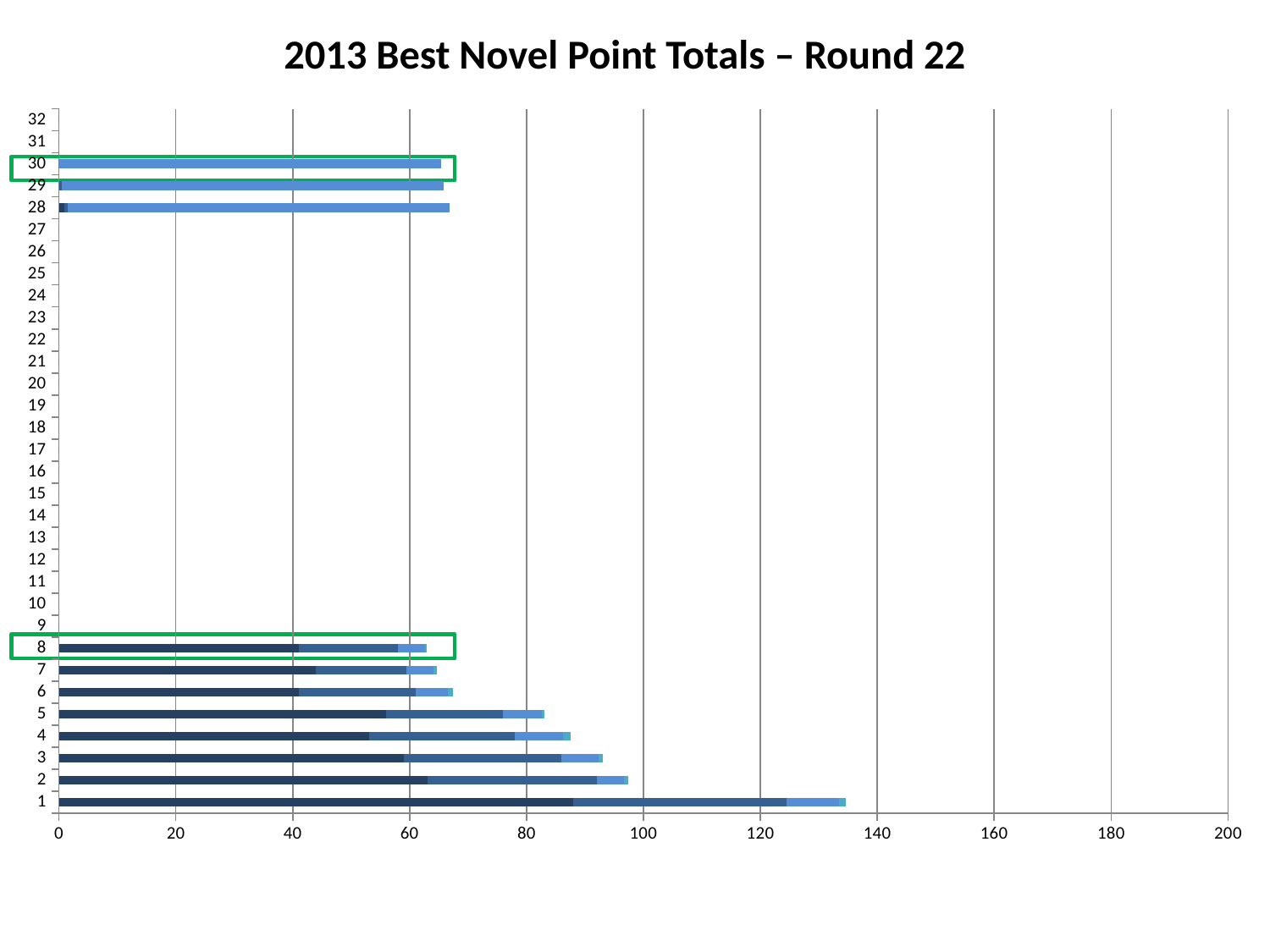
Is the total value for category 1 greater or less than 120? greater Is the total value for category 5 greater or less than 80? greater Is the total value for category 2 greater or less than 100? less Which has a larger total, category 1 or category 2? 1 What kind of chart is shown on the slide? bar chart How many category labels are shown on the vertical axis? 32 What is the title of the chart? 2013 Best Novel Point Totals – Round 22 Which category has the longest bar? 1 Which two categories are highlighted with green boxes? 8 and 30 Which has a larger total, category 3 or category 7? 3